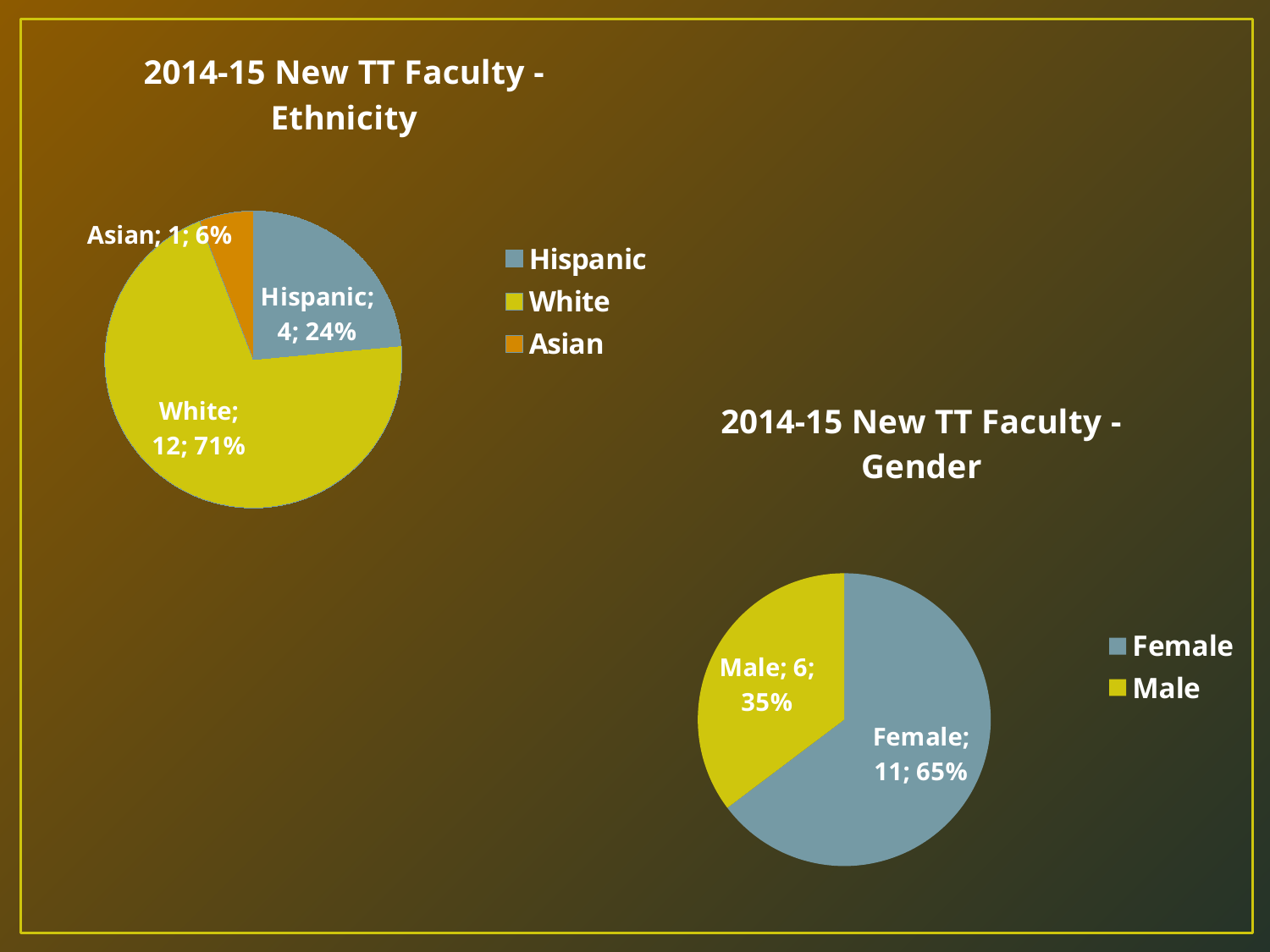
In the '2014-15 New TT Faculty - Gender' chart, what colour is the Male slice? Yellow In the '2014-15 New TT Faculty - Ethnicity' chart, what is the total number of new faculty across all slices? 17 In the '2014-15 New TT Faculty - Ethnicity' chart, what percentage share does the Hispanic slice have? 24% In the '2014-15 New TT Faculty - Ethnicity' chart, how many more White faculty are there than Hispanic faculty? 8 In the '2014-15 New TT Faculty - Gender' chart, what percentage share does the Male slice have? 35% What type of chart is the '2014-15 New TT Faculty - Gender' chart? Pie chart In the '2014-15 New TT Faculty - Gender' chart, which is larger, the Female slice or the Male slice? Female In the '2014-15 New TT Faculty - Ethnicity' chart, which ethnicity has the largest slice? White In the '2014-15 New TT Faculty - Ethnicity' chart, how many new faculty are White? 12 In the '2014-15 New TT Faculty - Gender' chart, how many new faculty are Female? 11 In the '2014-15 New TT Faculty - Ethnicity' chart, which ethnicity has the smallest slice? Asian In the '2014-15 New TT Faculty - Ethnicity' chart, how many categories are shown? 3